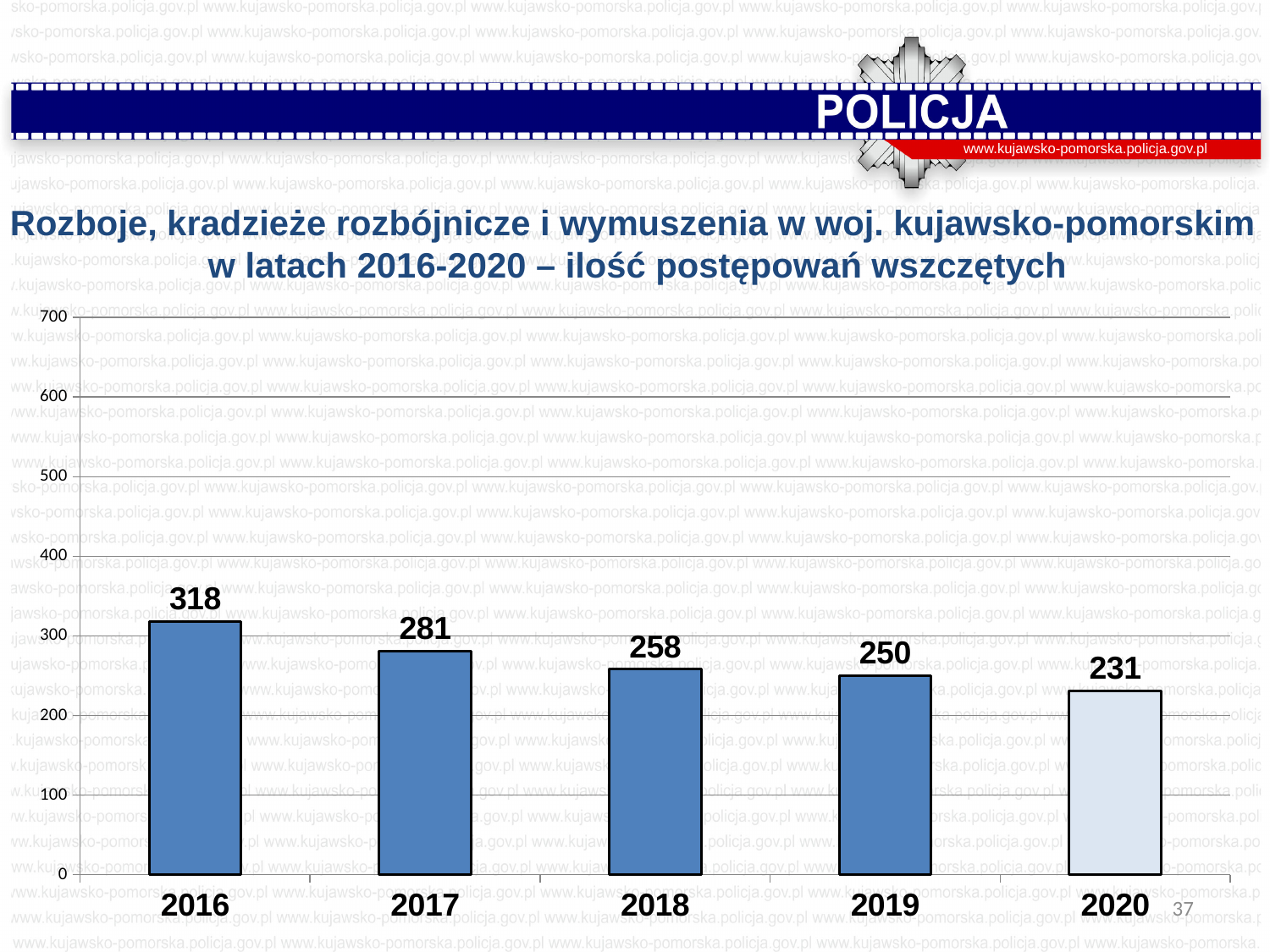
What is the value for 2018? 258 What is the difference between the values for 2016 and 2020? 87 Which year has the lowest value? 2020 Which is larger, the value for 2017 or the value for 2018? 2017 Which year has the highest value? 2016 Is the value for 2019 greater or less than 300? less How many years are shown on the chart? 5 What is the difference between the values for 2017 and 2019? 31 What kind of chart is shown on the slide? bar chart Do the values rise or fall from 2016 to 2020? fall What is the value for 2020? 231 What is the value for 2016? 318